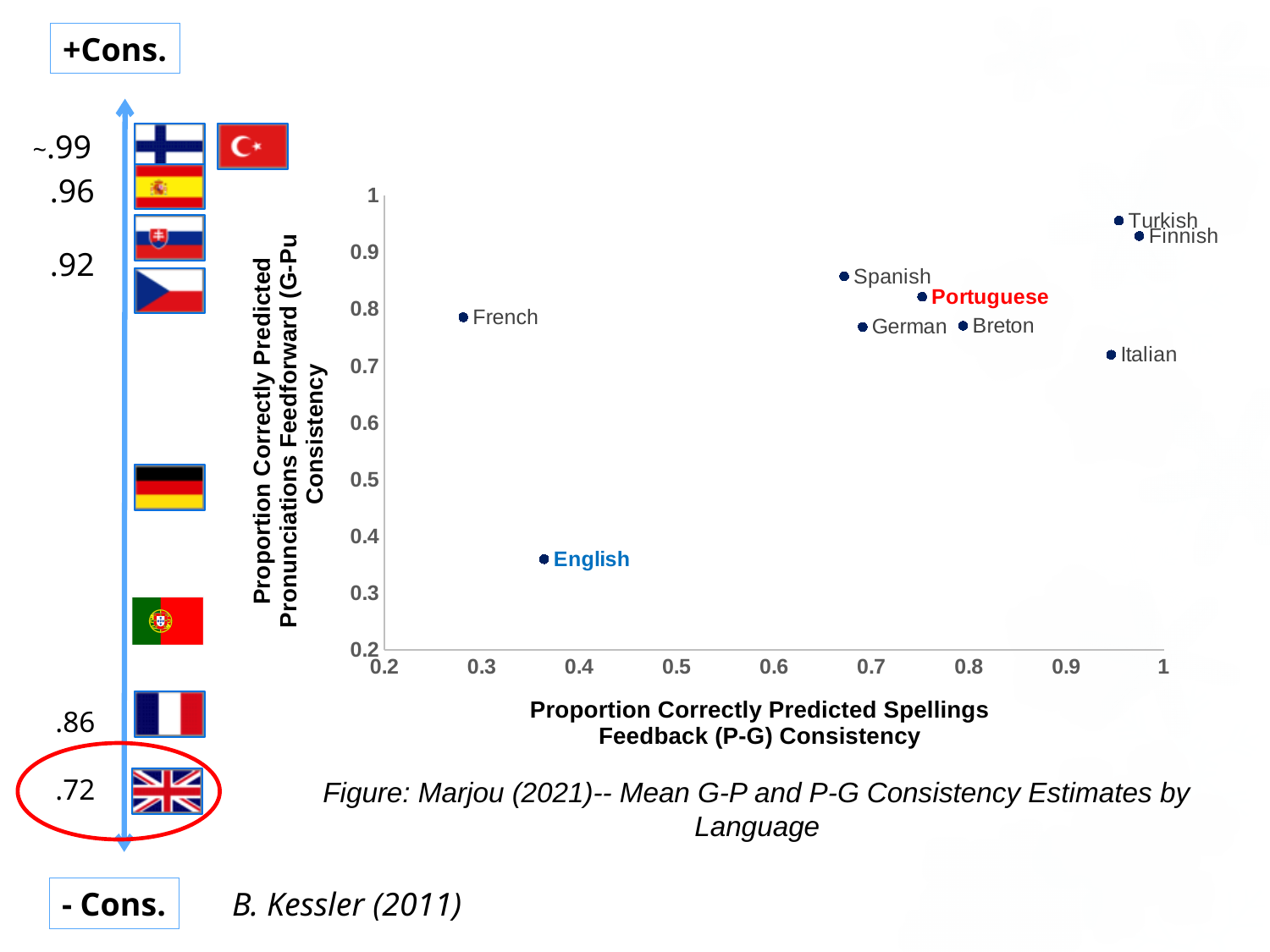
What kind of chart is shown on the slide? Scatter chart Which language has the lowest value on the horizontal axis (Proportion Correctly Predicted Spellings)? French Is the vertical-axis value for Turkish greater or less than 0.9? greater Which has the larger horizontal-axis value, Italian or Breton? Italian Is the vertical-axis value for Italian greater or less than 0.7? greater How many languages are plotted as points on the chart? 9 Which language has the lowest value on the vertical axis (Proportion Correctly Predicted Pronunciations)? English Which language has the highest value on the vertical axis (Proportion Correctly Predicted Pronunciations)? Turkish What is the title of the horizontal axis of the chart? Proportion Correctly Predicted Spellings Feedback (P-G) Consistency Is the horizontal-axis value for French greater or less than 0.3? less Which has the higher vertical-axis value, Spanish or German? Spanish